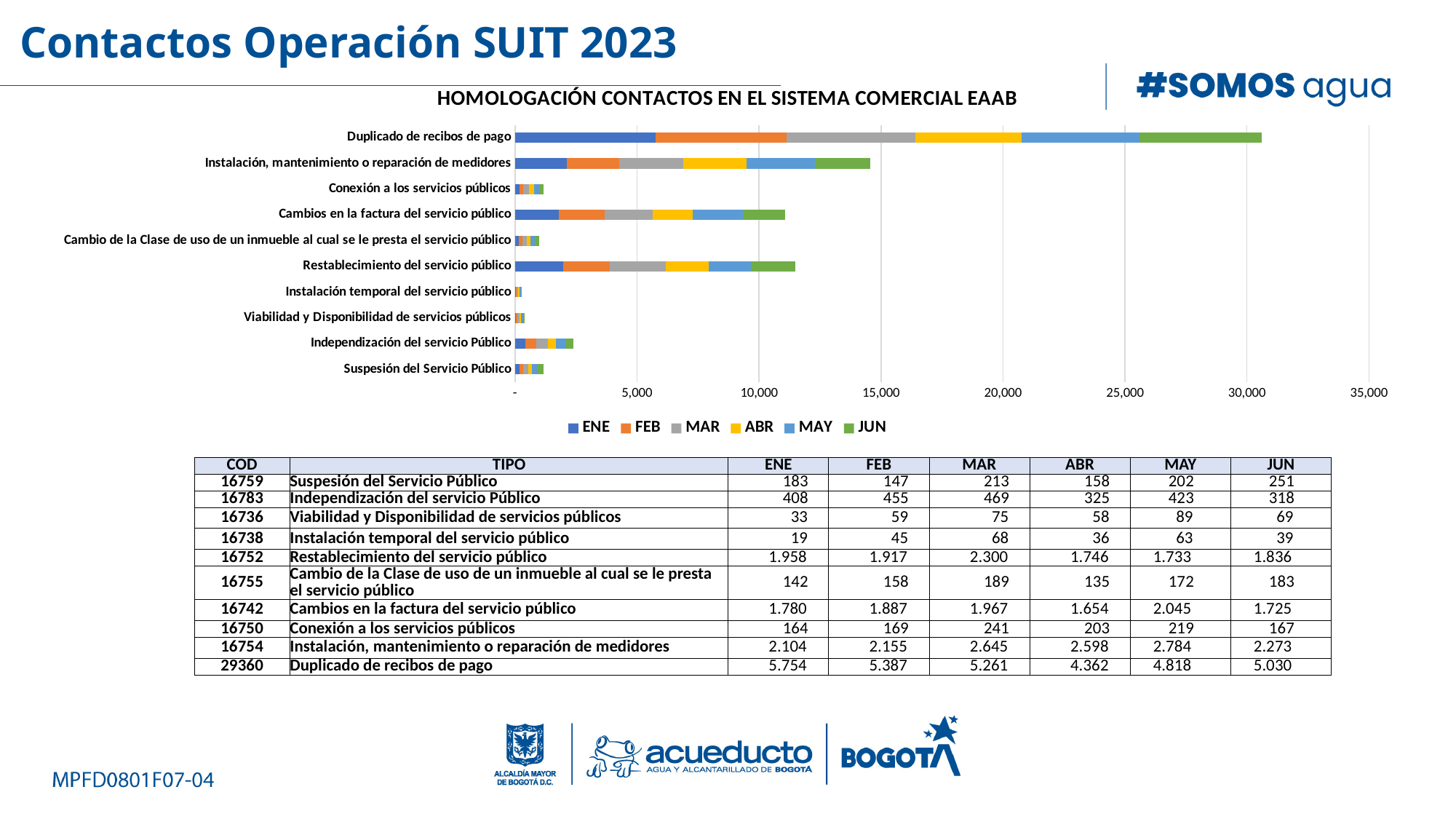
Which bar is longer: Instalación, mantenimiento o reparación de medidores or Cambios en la factura del servicio público? Instalación, mantenimiento o reparación de medidores What is the MAY value for Cambios en la factura del servicio público? 2.045 What is the ENE value for Duplicado de recibos de pago? 5.754 How many categories are plotted on the chart? 10 What is the total of the stacked bar for Suspesión del Servicio Público? 1.154 Is the total bar for Instalación, mantenimiento o reparación de medidores greater or less than 15,000? less What is the title of the chart? HOMOLOGACIÓN CONTACTOS EN EL SISTEMA COMERCIAL EAAB Which category has the longest bar in the chart? Duplicado de recibos de pago What is the total of the stacked bar for Duplicado de recibos de pago? 30.612 What is the difference between the ENE values for Duplicado de recibos de pago and Instalación, mantenimiento o reparación de medidores? 3.650 What kind of chart is shown on the slide? Stacked bar chart How many series does the chart legend list? 6